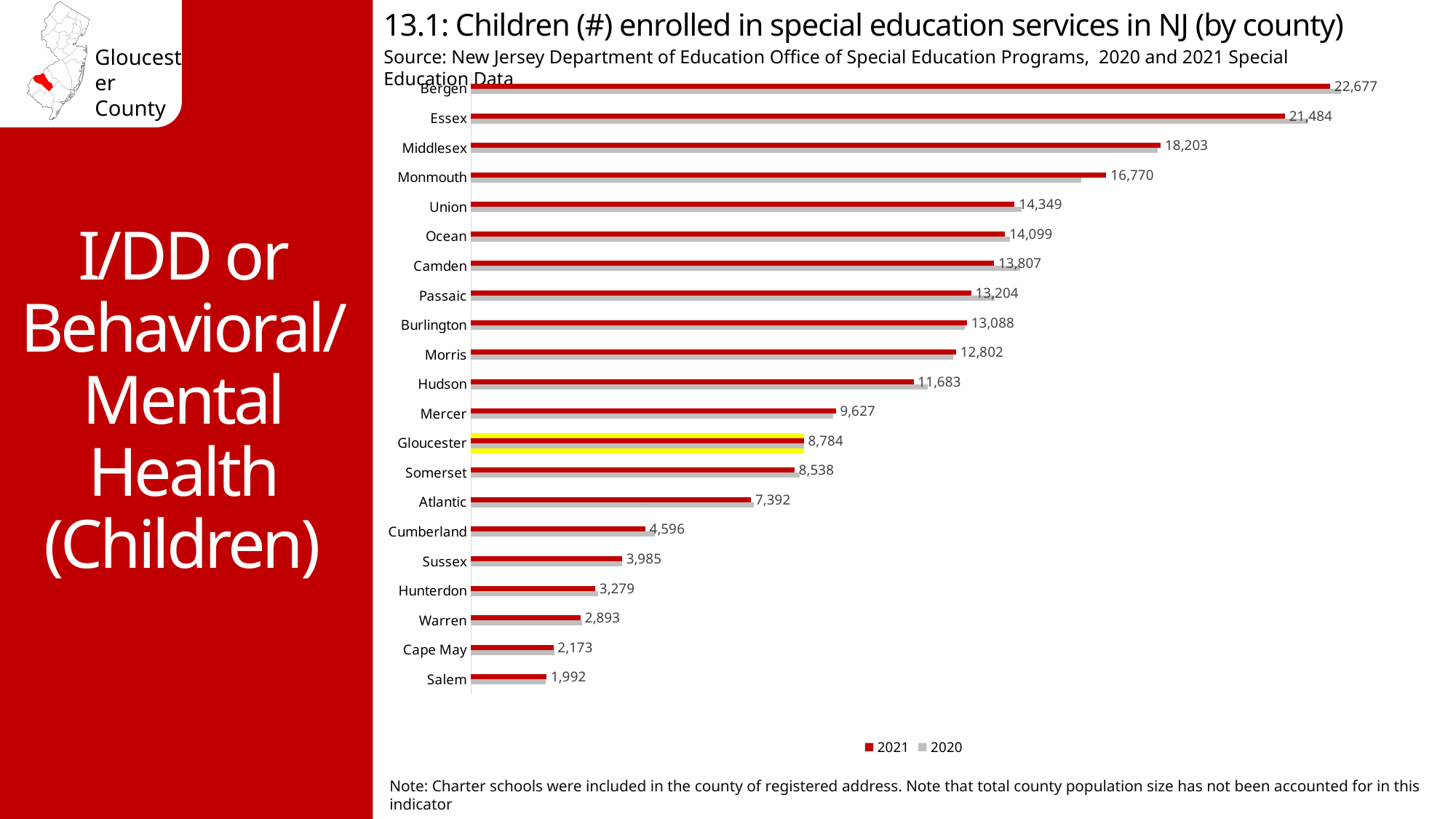
Which county's bars are highlighted in yellow on the chart? Gloucester How many series does the legend list? 2 How many counties are shown on the chart? 21 What is the 2021 value for Gloucester County? 8,784 What is the 2021 value for Bergen County? 22,677 Which county has the highest number of children enrolled in special education services in 2021? Bergen Which county has the lowest number of children enrolled in special education services in 2021? Salem What is the difference between the 2021 values for Gloucester and Somerset? 246 What is the difference between the 2021 values for Bergen and Essex? 1,193 What kind of chart is shown on the slide? Bar chart Which county has a larger 2021 value, Camden or Passaic? Camden What is the 2021 value for Cumberland County? 4,596